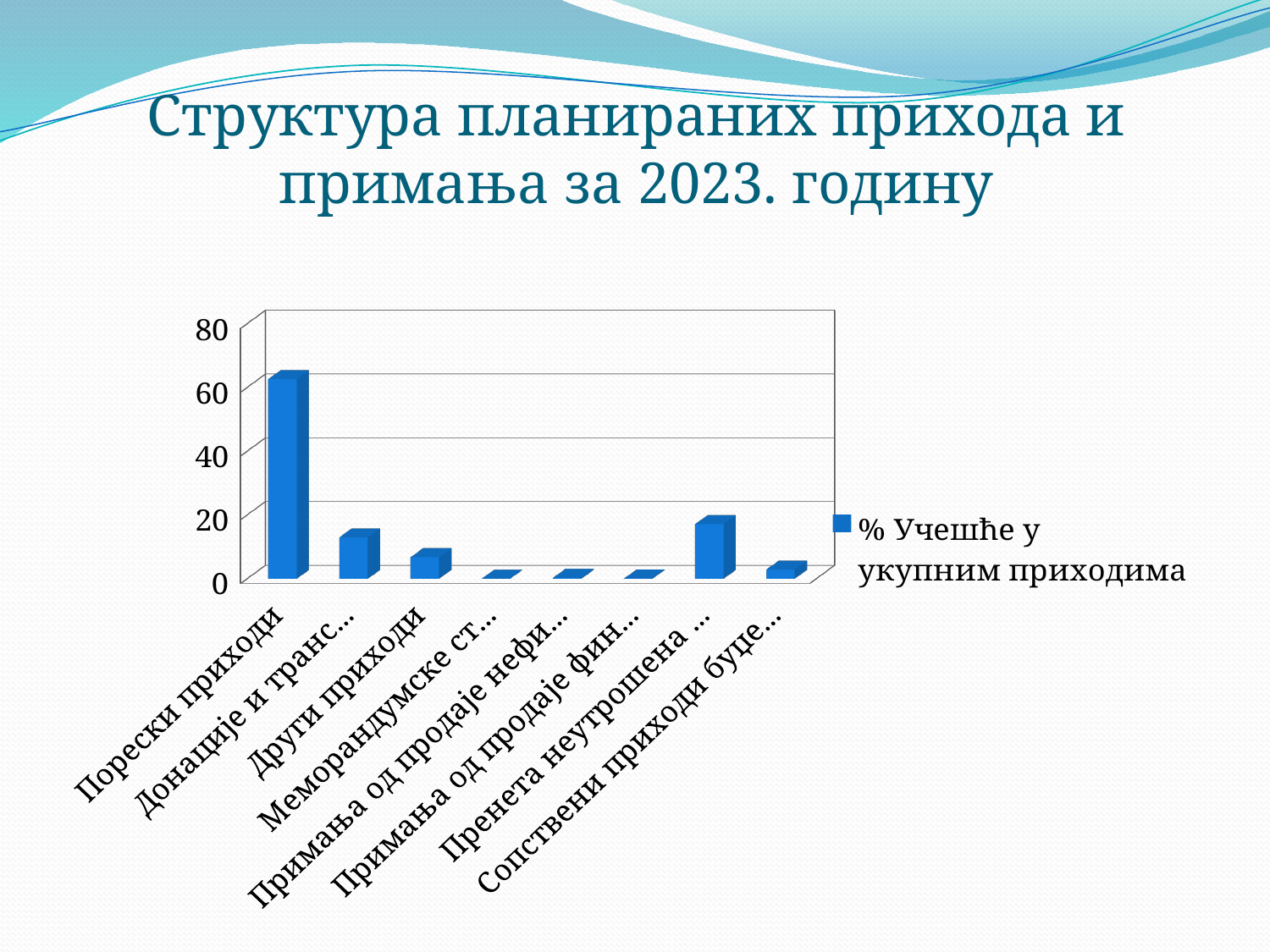
Is the value for Други приходи greater or less than 20? less Which is larger, the value for Донације и транс... or the value for Други приходи? Донације и транс... Is the value for Донације и транс... greater or less than 20? less What is the title of the slide containing the chart? Структура планираних прихода и примања за 2023. годину How many series does the legend list? 1 Which is larger, the value for Порески приходи or the value for Пренета неутрошена ...? Порески приходи What is the name of the series shown in the legend? % Учешће у укупним приходима Which category has the highest value in the chart? Порески приходи What kind of chart is shown on the slide? bar chart Is the value for Порески приходи greater or less than 40? greater How many categories are shown on the x axis of the chart? 8